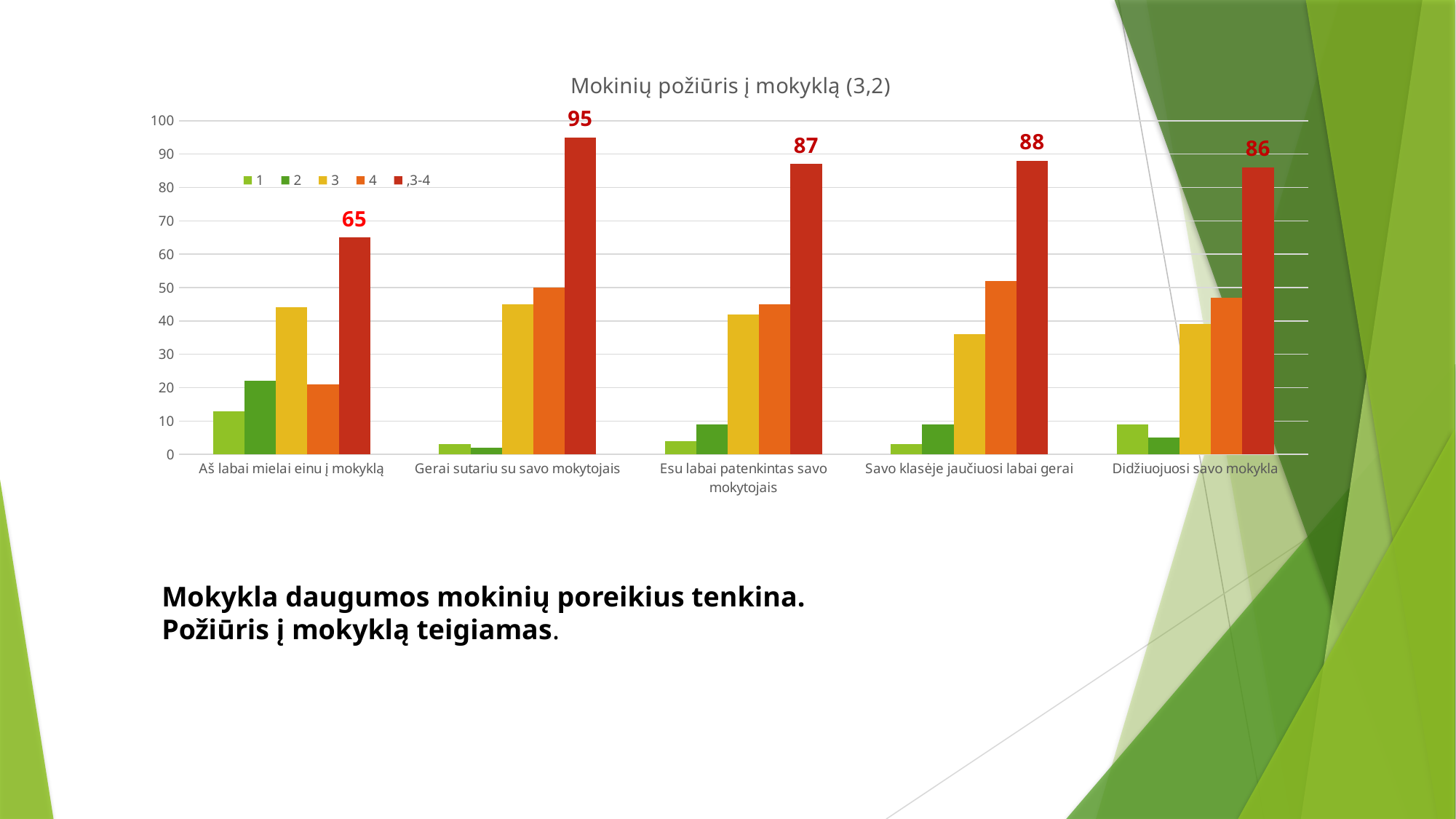
How many categories are shown on the x axis? 5 Is the value of series "4" for "Savo klasėje jaučiuosi labai gerai" greater or less than 40? greater What kind of chart is shown on the slide? Bar chart What is the value of the ",3-4" series for "Gerai sutariu su savo mokytojais"? 95 Is the value of series "2" for "Gerai sutariu su savo mokytojais" greater or less than 10? less What is the difference between the ",3-4" values for "Gerai sutariu su savo mokytojais" and "Aš labai mielai einu į mokyklą"? 30 What is the value of the ",3-4" series for "Didžiuojuosi savo mokykla"? 86 What is the value of the ",3-4" series for "Aš labai mielai einu į mokyklą"? 65 Which category has the highest value for the ",3-4" series? Gerai sutariu su savo mokytojais How many series does the legend list? 5 Which is larger for the ",3-4" series: "Esu labai patenkintas savo mokytojais" or "Savo klasėje jaučiuosi labai gerai"? Savo klasėje jaučiuosi labai gerai Which category has the lowest value for the ",3-4" series? Aš labai mielai einu į mokyklą